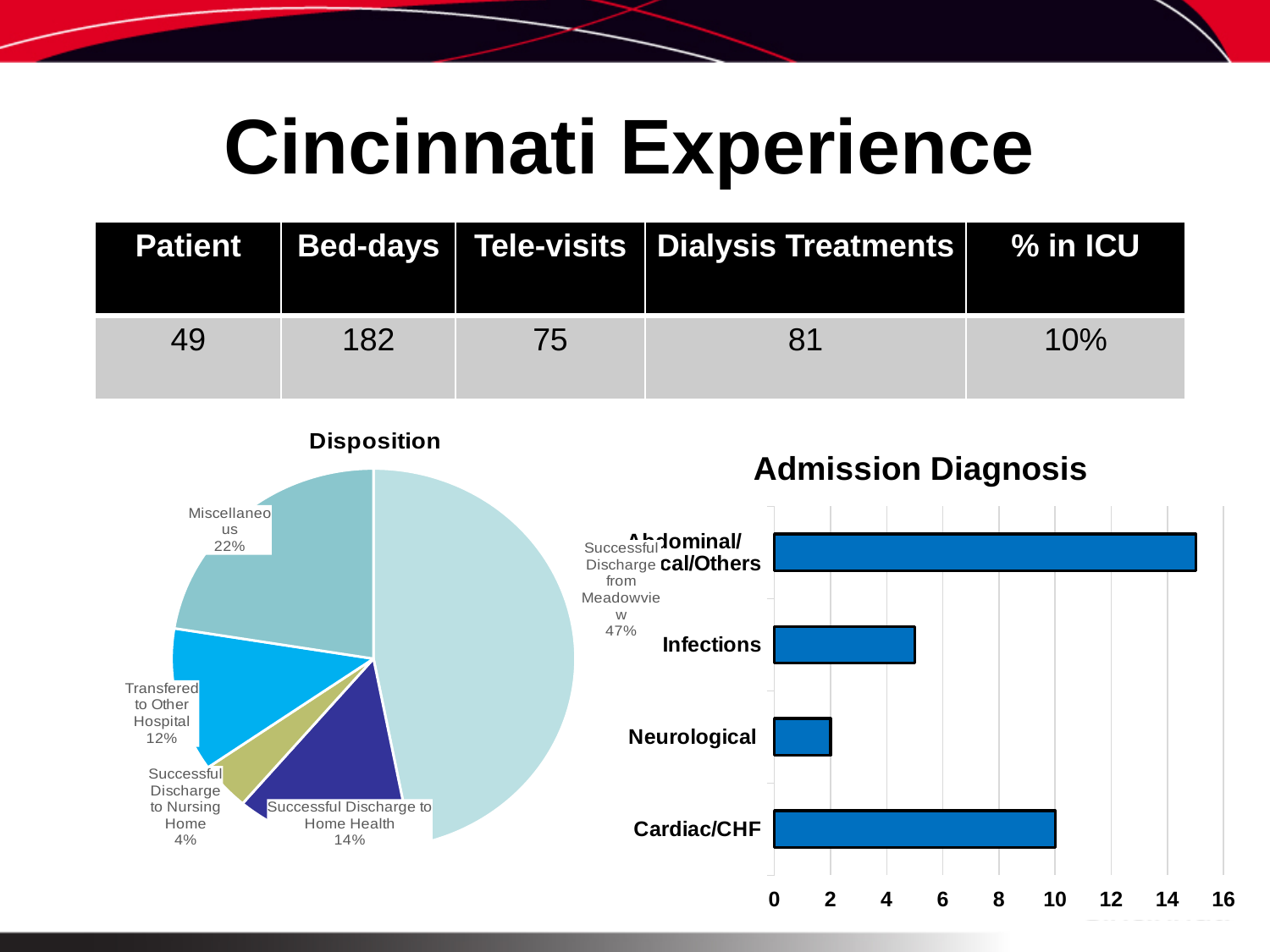
In the Disposition pie chart, what is the difference between the Miscellaneous share and the Transferred to Other Hospital share? 10% What type of chart is the Disposition chart? pie chart What type of chart is the Admission Diagnosis chart? bar chart In the Disposition pie chart, what share is Miscellaneous? 22% In the Admission Diagnosis chart, what is the value for Cardiac/CHF? 10 In the Admission Diagnosis chart, which has the larger value, Cardiac/CHF or Infections? Cardiac/CHF In the Disposition pie chart, which slice is the smallest? Successful Discharge to Nursing Home In the Disposition pie chart, how many slices are there? 5 In the Admission Diagnosis chart, is the value for Infections greater or less than 4? greater In the Admission Diagnosis chart, what is the value for Neurological? 2 In the Disposition pie chart, which slice is the largest? Successful Discharge from Meadowview In the Disposition pie chart, what share is Successful Discharge from Meadowview? 47%